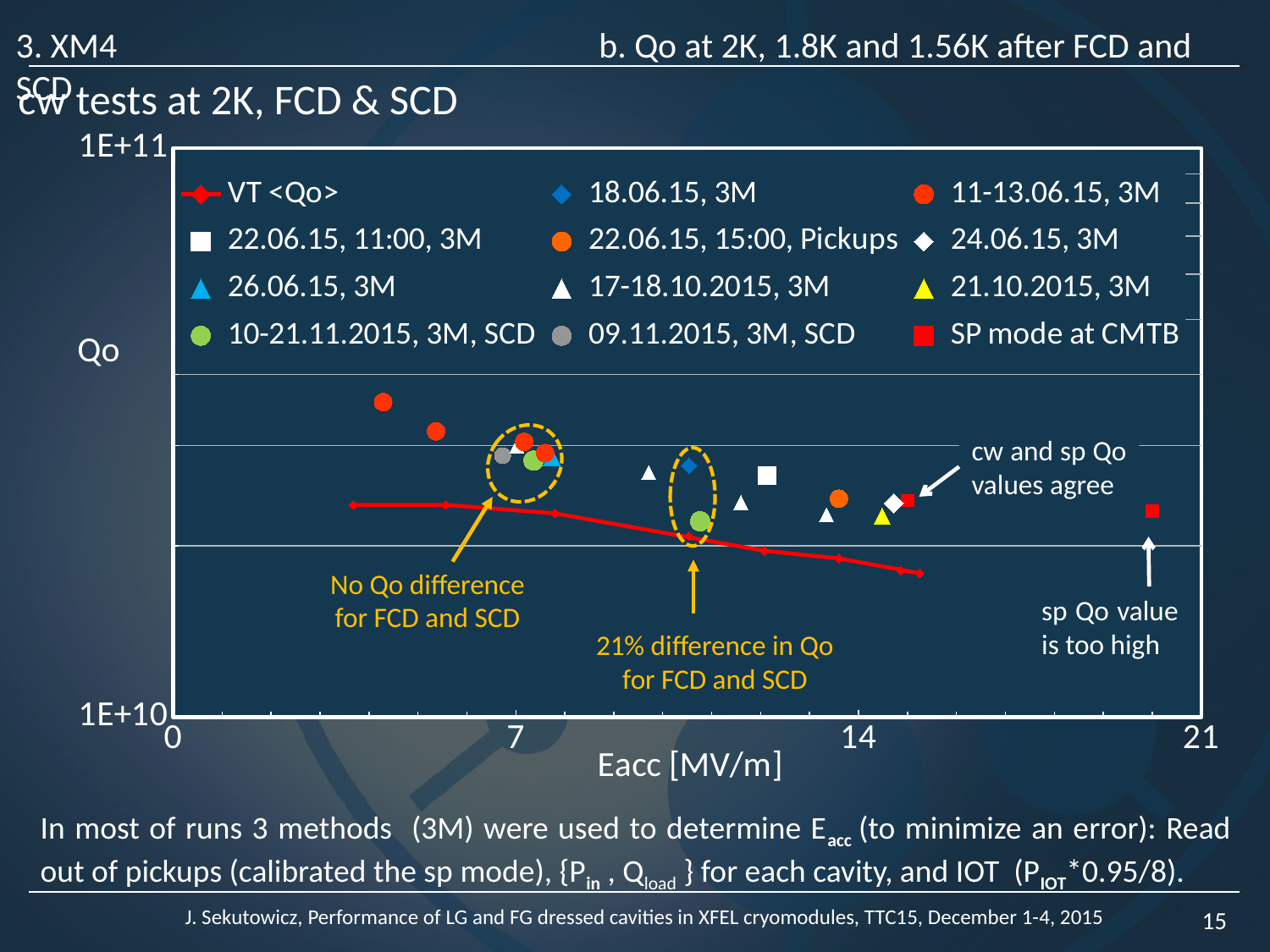
What kind of chart is shown on the slide? scatter chart What is the label of the x axis of the chart? Eacc [MV/m] Is the Qo value of the rightmost SP mode at CMTB point greater or less than 1E+10? greater Is the Eacc value of the 22.06.15, 11:00, 3M point greater or less than 14? less Is the Eacc value of the rightmost SP mode at CMTB point greater or less than 14? greater At Eacc around 4 MV/m, which is higher: the 11-13.06.15, 3M point or the VT <Qo> line? 11-13.06.15, 3M Which series has the highest Qo point on the chart? 11-13.06.15, 3M Does the VT <Qo> line rise or fall as Eacc increases? fall How many series does the chart legend list? 12 Which series reaches the lowest Qo value on the chart? VT <Qo> According to the annotation on the chart, what is the percentage difference in Qo between FCD and SCD at the point near Eacc 10.5 MV/m? 21%